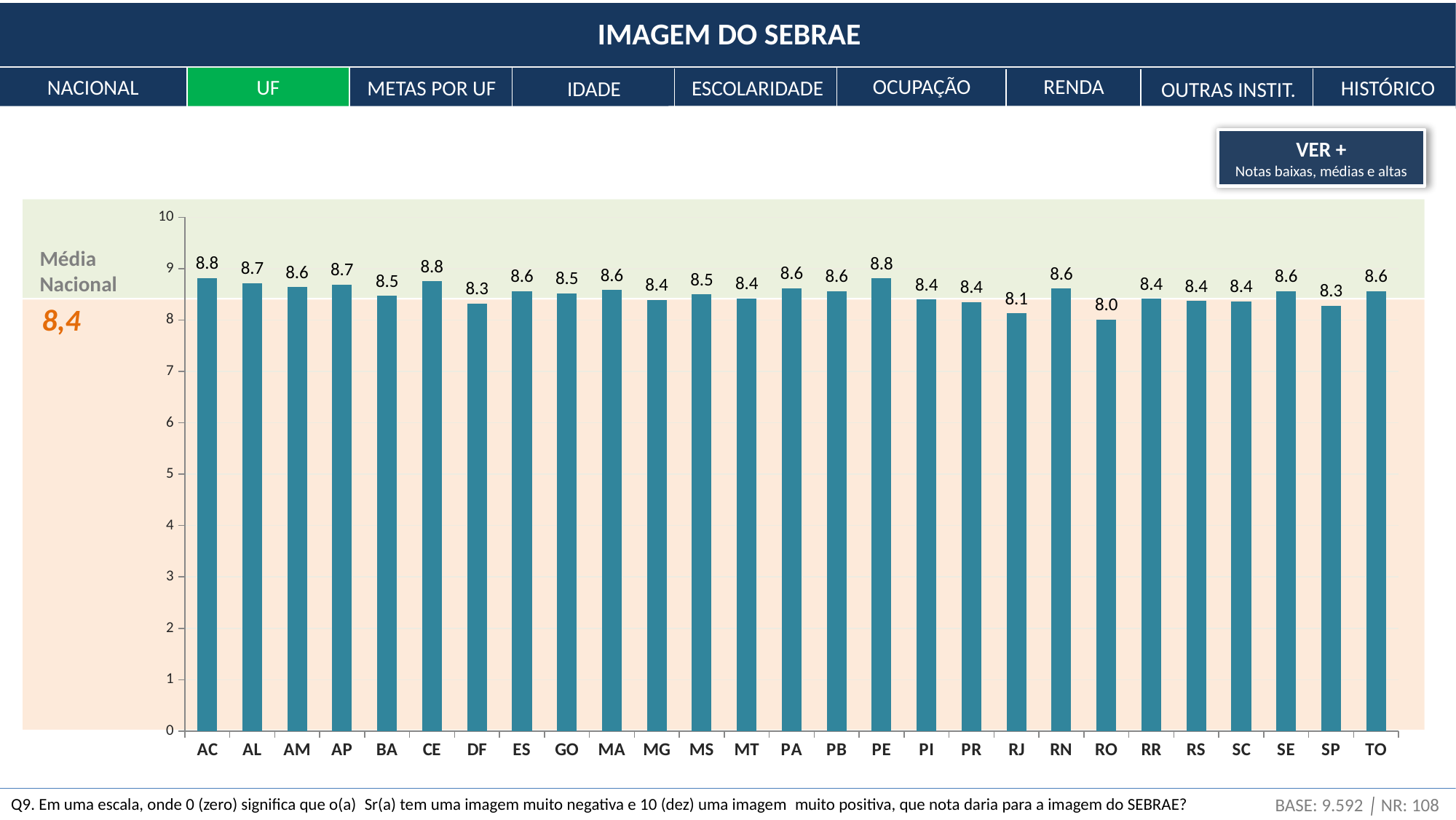
What is the value for RO? 8.0 What kind of chart is shown on the slide? bar chart Which has a larger value, AP or BA? AP What is the difference between the values for AL and SP? 0.4 What is the difference between the values for PE and RO? 0.8 Which state has the lowest value? RO What is the value for CE? 8.8 How many states are shown on the x axis? 27 Which has a larger value, RJ or RN? RN What is the value for DF? 8.3 What is the value for RJ? 8.1 What is the Média Nacional value shown on the slide? 8,4